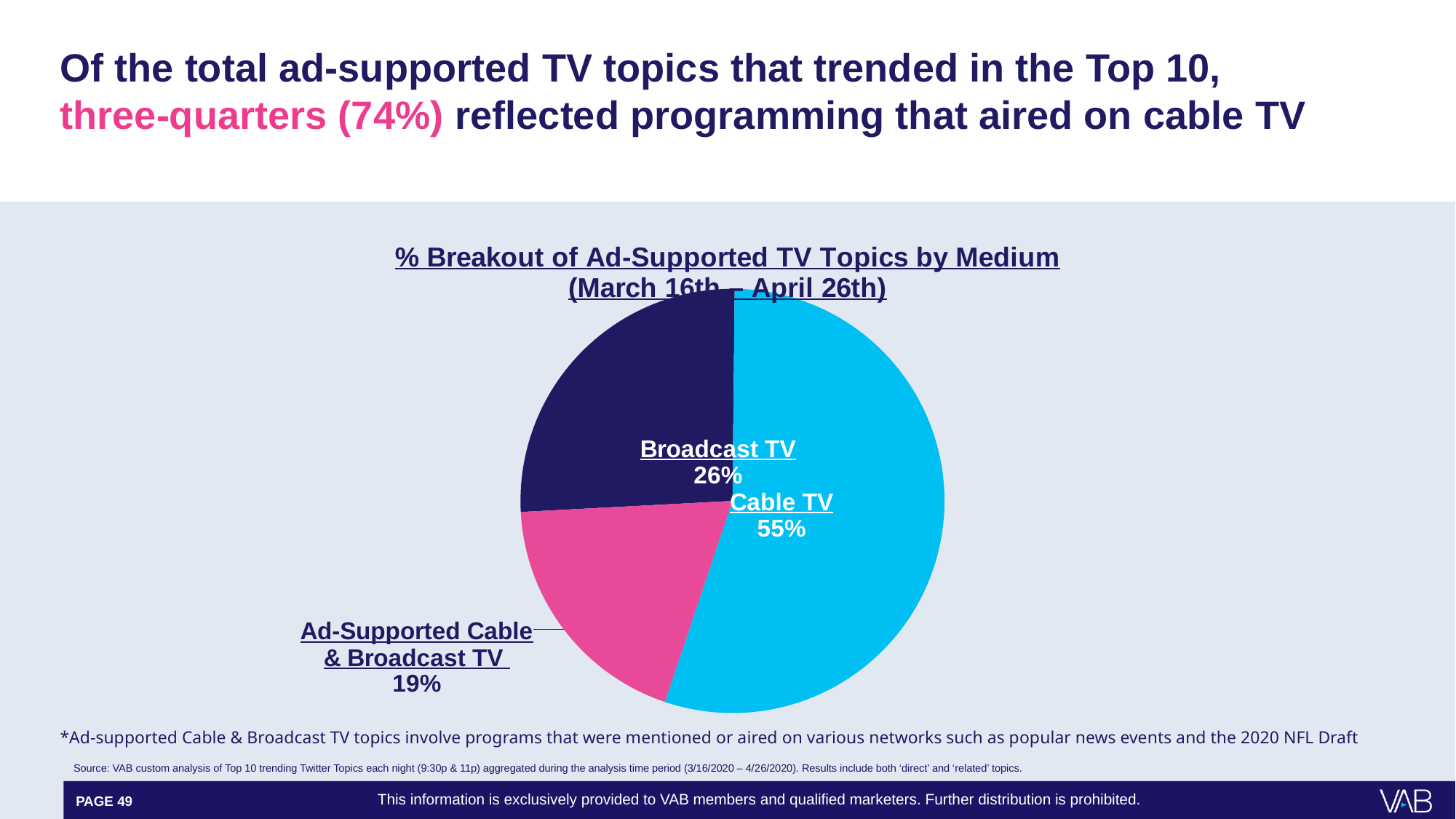
What is the title of the pie chart? % Breakout of Ad-Supported TV Topics by Medium (March 16th – April 26th) Which is larger, the share for Broadcast TV or the share for Ad-Supported Cable & Broadcast TV? Broadcast TV What percentage of ad-supported TV topics is attributed to Broadcast TV? 26% What kind of chart is shown on the slide? Pie chart What is the difference in percentage points between the Cable TV share and the Broadcast TV share? 29 How many slices does the pie chart have? 3 What colour is the Cable TV slice of the pie chart? Light blue Which medium has the largest share of the pie? Cable TV Which medium has the smallest share of the pie? Ad-Supported Cable & Broadcast TV What is the difference in percentage points between the Broadcast TV share and the Ad-Supported Cable & Broadcast TV share? 7 What percentage of ad-supported TV topics is attributed to Ad-Supported Cable & Broadcast TV? 19% What percentage of ad-supported TV topics is attributed to Cable TV? 55%